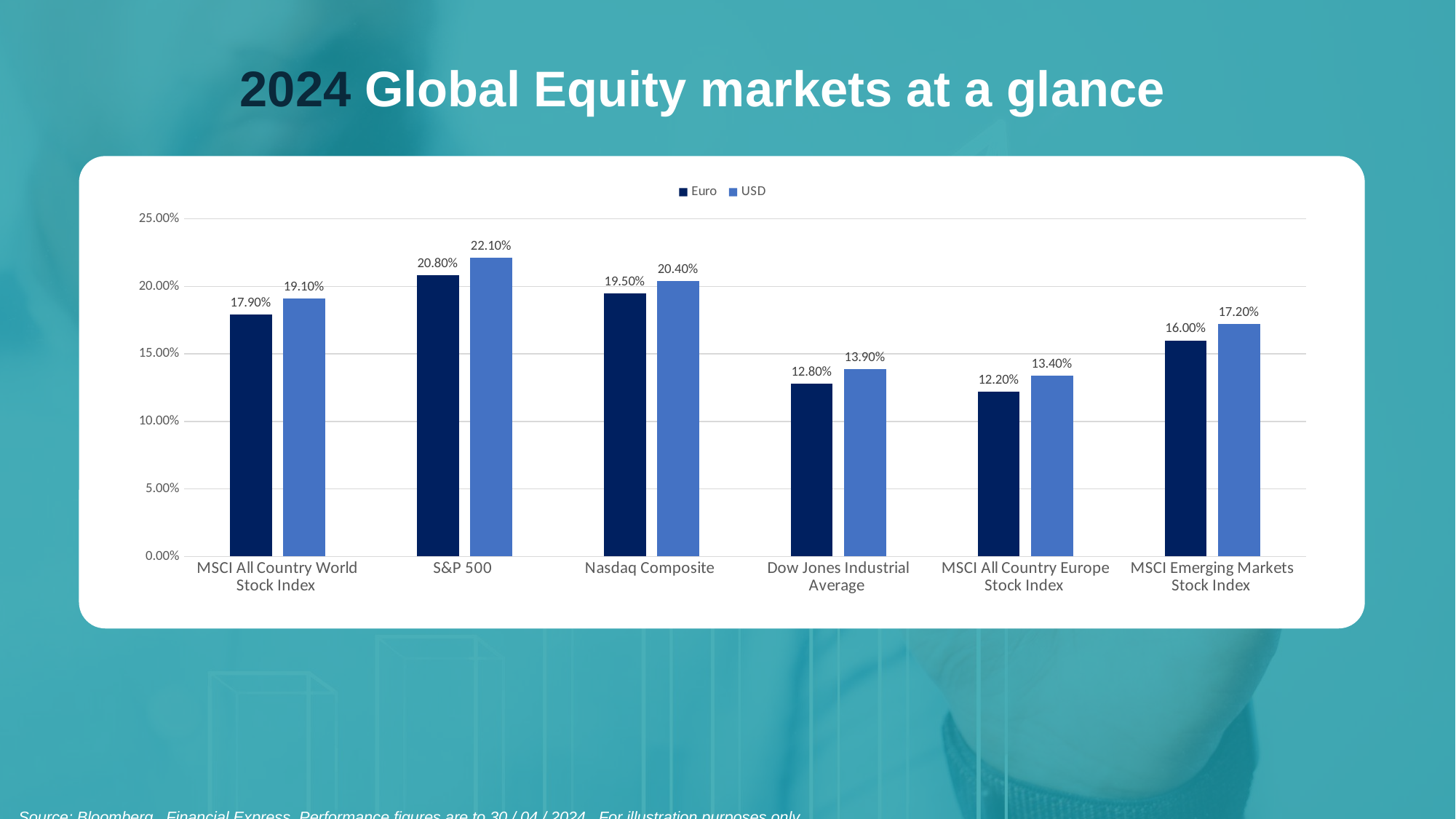
What is the Euro value for the S&P 500? 20.80% What is the difference between the USD and Euro values for the Nasdaq Composite? 0.90% Which index has the highest USD value? S&P 500 What kind of chart is shown on the slide? Bar chart Which index has the lowest Euro value? MSCI All Country Europe Stock Index What is the USD value for the MSCI Emerging Markets Stock Index? 17.20% What is the USD value for the Dow Jones Industrial Average? 13.90% Which is larger for the MSCI All Country World Stock Index, the Euro value or the USD value? USD What are the two series named in the legend? Euro and USD Is the Euro value for the Dow Jones Industrial Average greater or less than 15.00%? less How many series does the legend list? 2 How many indices are shown on the x axis? 6